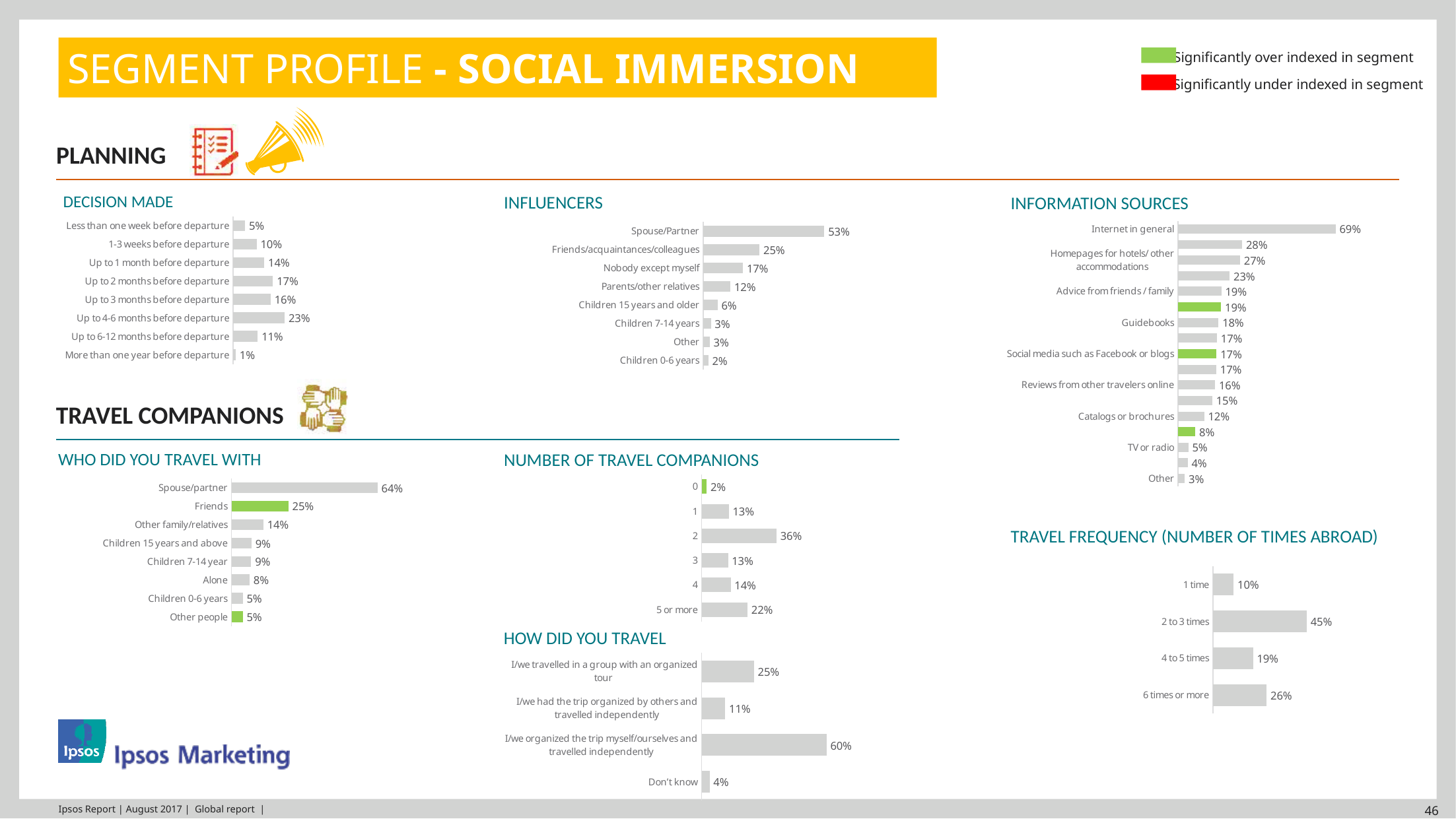
In the NUMBER OF TRAVEL COMPANIONS chart, what is the value for '5 or more'? 22% In the INFLUENCERS chart, what is the value for Spouse/Partner? 53% In the WHO DID YOU TRAVEL WITH chart, which is larger, Friends or Other family/relatives? Friends In the INFORMATION SOURCES chart, what is the value for Catalogs or brochures? 12% In the HOW DID YOU TRAVEL chart, which category has the highest value? I/we organized the trip myself/ourselves and travelled independently In the DECISION MADE chart, what is the value for 'Up to 4-6 months before departure'? 23% In the INFORMATION SOURCES chart, which category has the highest value? Internet in general In the TRAVEL FREQUENCY (NUMBER OF TIMES ABROAD) chart, what is the difference between '2 to 3 times' and '6 times or more'? 19% In the DECISION MADE chart, which category has the lowest value? More than one year before departure In the INFLUENCERS chart, what is the difference between Friends/acquaintances/colleagues and Nobody except myself? 8% How many categories are shown in the WHO DID YOU TRAVEL WITH chart? 8 What type of chart is the TRAVEL FREQUENCY (NUMBER OF TIMES ABROAD) chart? Bar chart